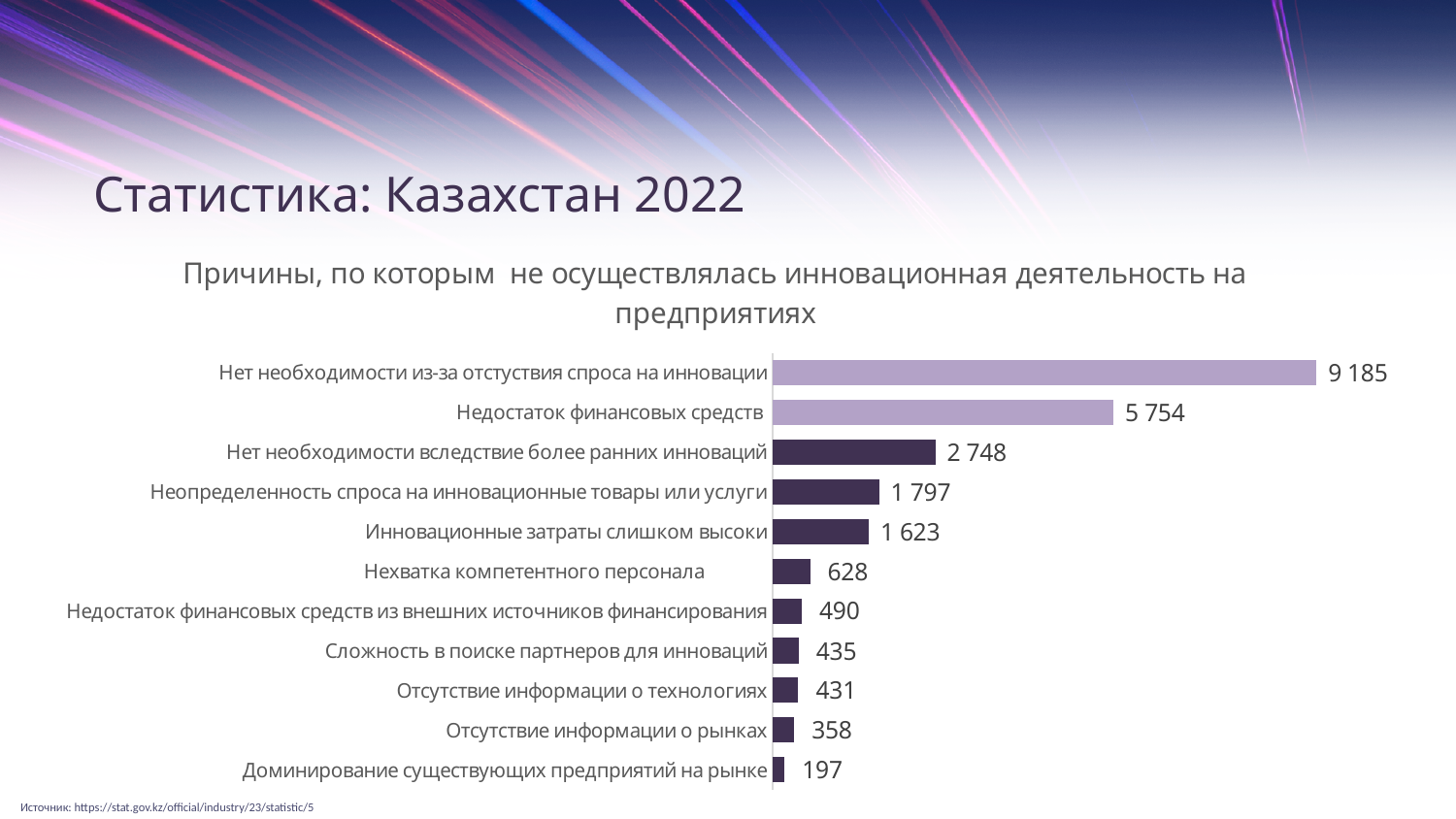
Which is larger: «Неопределенность спроса на инновационные товары или услуги» or «Инновационные затраты слишком высоки»? Неопределенность спроса на инновационные товары или услуги What is the value for «Нехватка компетентного персонала»? 628 Which category has the highest value? Нет необходимости из-за отстуствия спроса на инновации Which category has the lowest value? Доминирование существующих предприятий на рынке What is the value for «Отсутствие информации о рынках»? 358 What is the difference between «Нет необходимости из-за отстуствия спроса на инновации» and «Недостаток финансовых средств»? 3 431 What is the title of the chart? Причины, по которым не осуществлялась инновационная деятельность на предприятиях What is the difference between «Нет необходимости вследствие более ранних инноваций» and «Неопределенность спроса на инновационные товары или услуги»? 951 What kind of chart is shown on the slide? Bar chart How many categories are shown in the chart? 11 What is the value for «Нет необходимости из-за отстуствия спроса на инновации»? 9 185 What is the value for «Недостаток финансовых средств»? 5 754